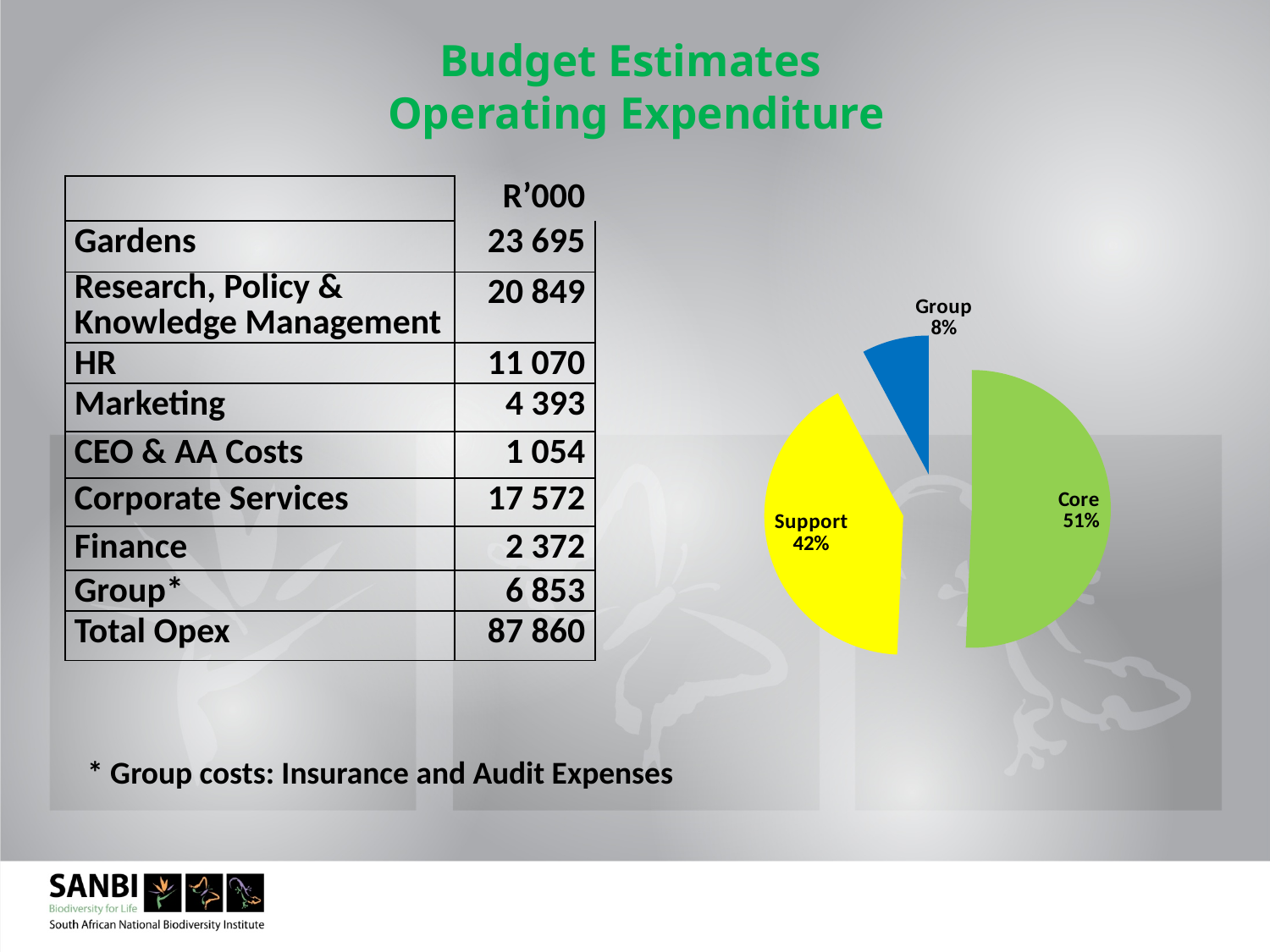
Which is larger in the pie chart, Support or Group? Support What share of the pie chart does Core represent? 51% What colour is the Core slice of the pie chart? Green How many slices does the pie chart have? 3 Which slice of the pie chart is the smallest? Group What is the difference in percentage points between the Support and Group slices of the pie chart? 34 Which slice of the pie chart is the largest? Core What share of the pie chart does Group represent? 8% What is the difference in percentage points between the Core and Support slices of the pie chart? 9 What share of the pie chart does Support represent? 42% What kind of chart is shown on the slide? Pie chart What colour is the Group slice of the pie chart? Blue